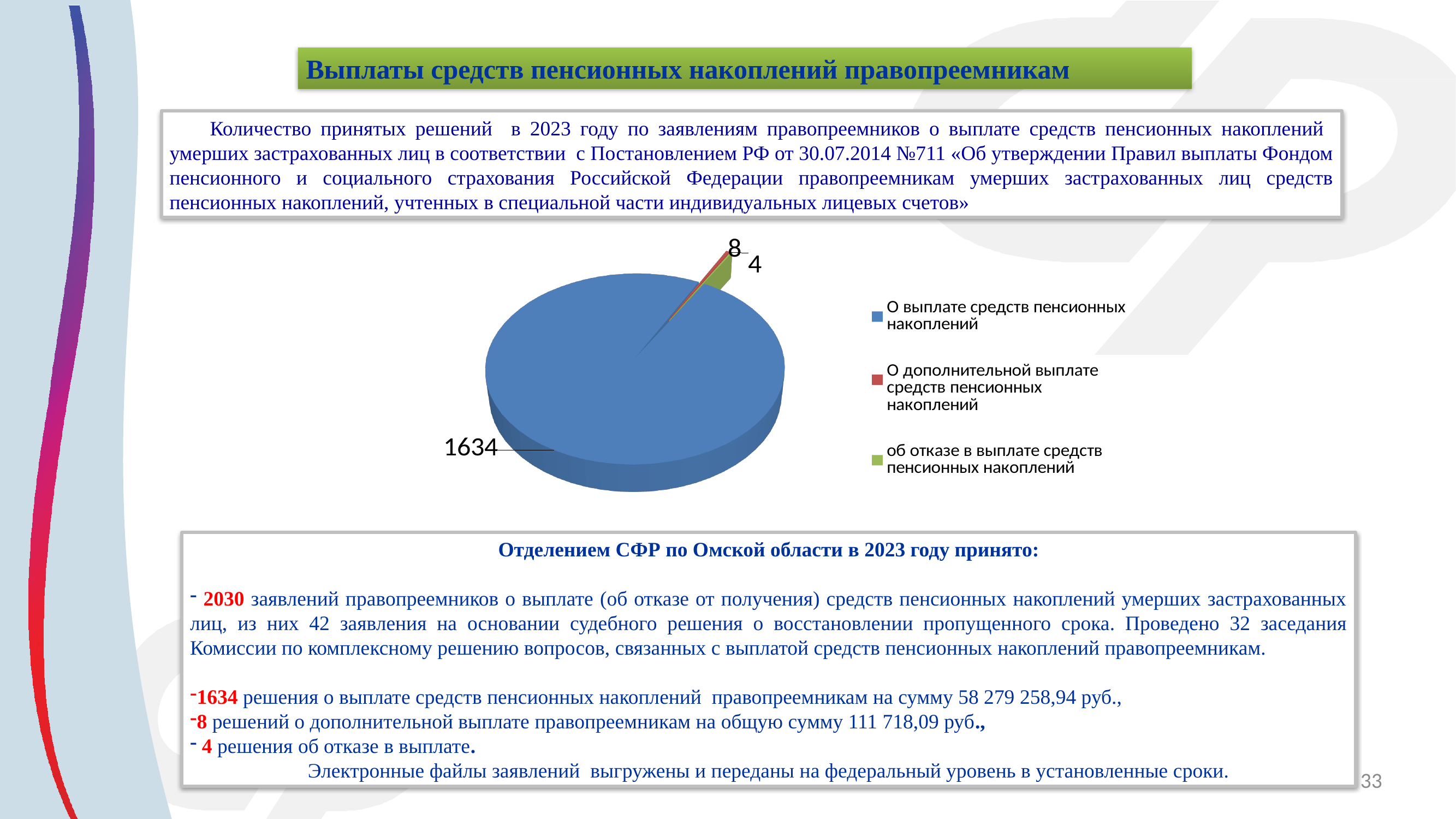
What is the value of the slice labelled "О дополнительной выплате средств пенсионных накоплений"? 8 What colour is the slice for "О выплате средств пенсионных накоплений"? Blue Which category has the smallest slice in the pie chart? об отказе в выплате средств пенсионных накоплений How many entries does the legend of the pie chart list? 3 What is the total of all three values shown in the pie chart? 1646 What type of chart is shown on the slide? Pie chart What is the difference between the value for "О дополнительной выплате средств пенсионных накоплений" and the value for "об отказе в выплате средств пенсионных накоплений"? 4 How many slices does the pie chart have? 3 What is the value of the slice labelled "О выплате средств пенсионных накоплений"? 1634 What is the value of the slice labelled "об отказе в выплате средств пенсионных накоплений"? 4 Which is larger: the value for "О дополнительной выплате средств пенсионных накоплений" or the value for "об отказе в выплате средств пенсионных накоплений"? О дополнительной выплате средств пенсионных накоплений Which category has the largest slice in the pie chart? О выплате средств пенсионных накоплений